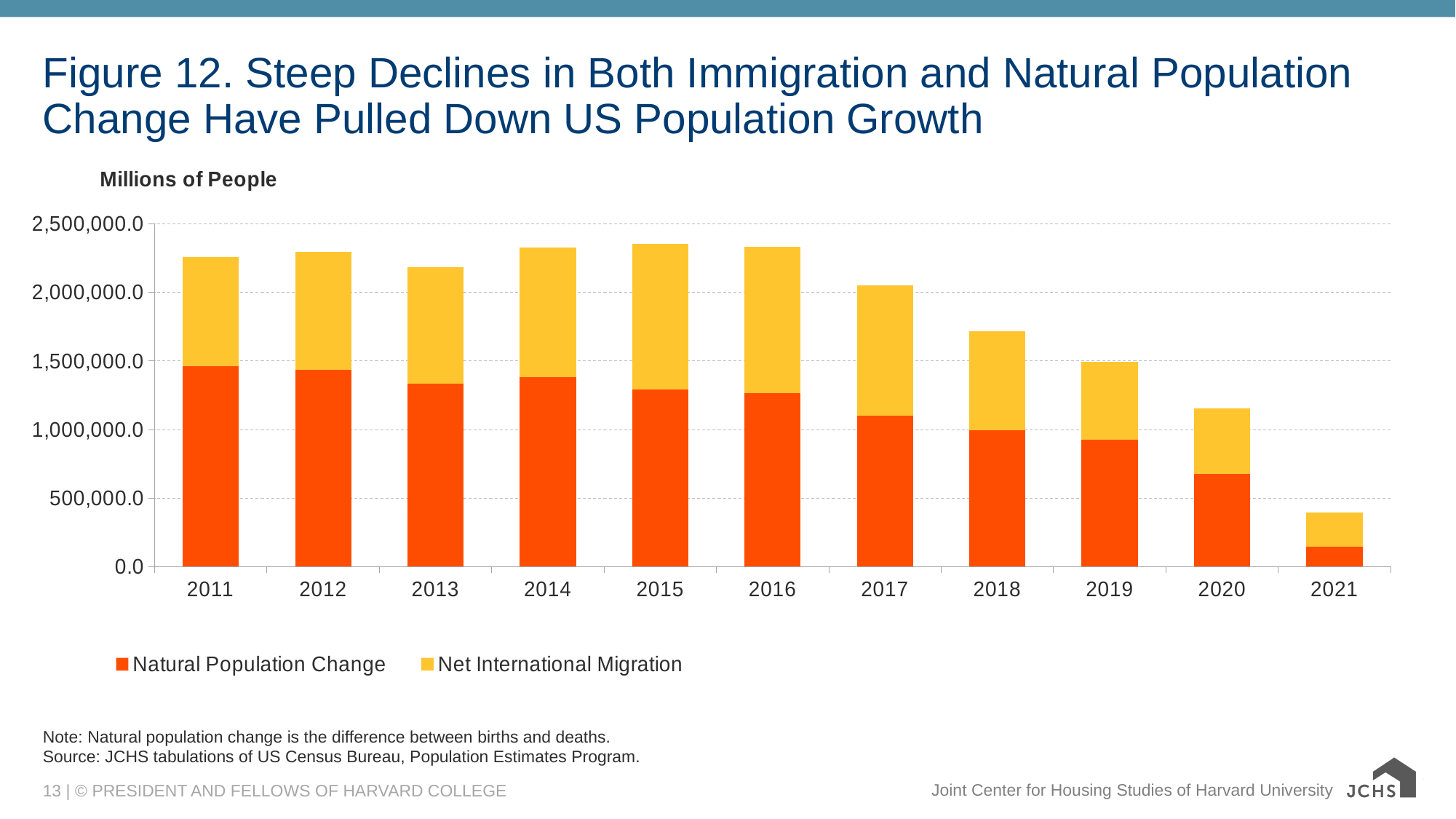
Which year has the lowest total bar? 2021 Is the total bar for 2021 greater or less than 500,000.0? less How many years are shown on the x axis of the chart? 11 Is the total bar for 2017 greater or less than 2,000,000.0? greater Which year has the smallest Natural Population Change segment? 2021 Do the total bars generally rise or fall from 2016 to 2021? fall Which colour represents Net International Migration in the chart? Yellow How many series does the legend list? 2 Is the total bar for 2018 greater or less than 1,500,000.0? greater Which year has the larger total bar, 2017 or 2018? 2017 What kind of chart is shown on the slide? Stacked bar chart